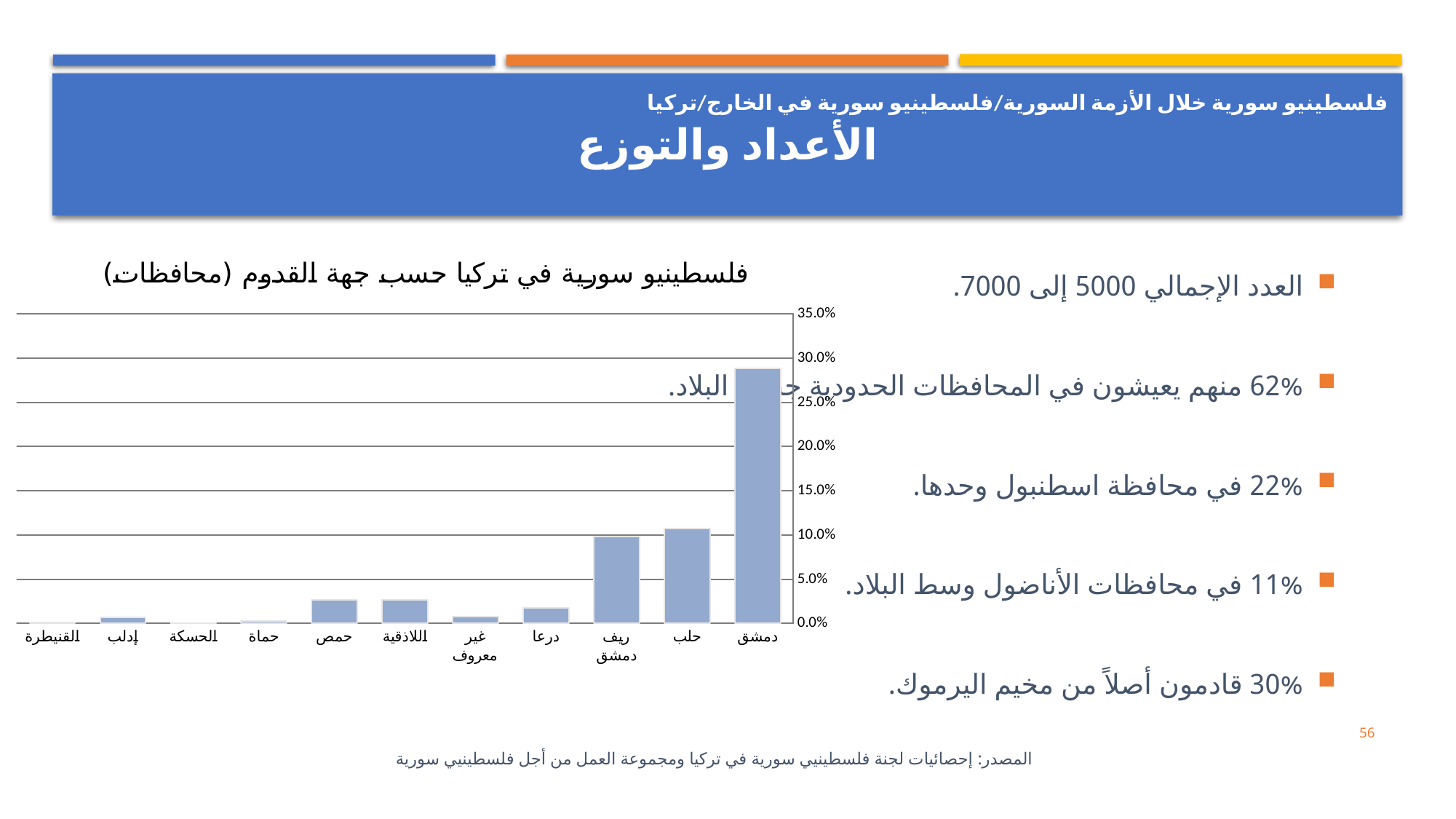
What is the highest value shown on the chart's vertical axis? 35.0% Is the value for دمشق greater or less than 25.0%? greater How many governorate categories are shown on the x axis of the chart? 11 What is the title of the chart? فلسطينيو سورية في تركيا حسب جهة القدوم (محافظات) Is the value for حمص greater or less than 5.0%? less Which is larger, the value for حمص or the value for درعا? حمص Which category has the highest bar in the chart? دمشق Which is larger, the value for دمشق or the value for حلب? دمشق Is the value for حلب greater or less than 15.0%? less What kind of chart is shown on the slide? bar chart